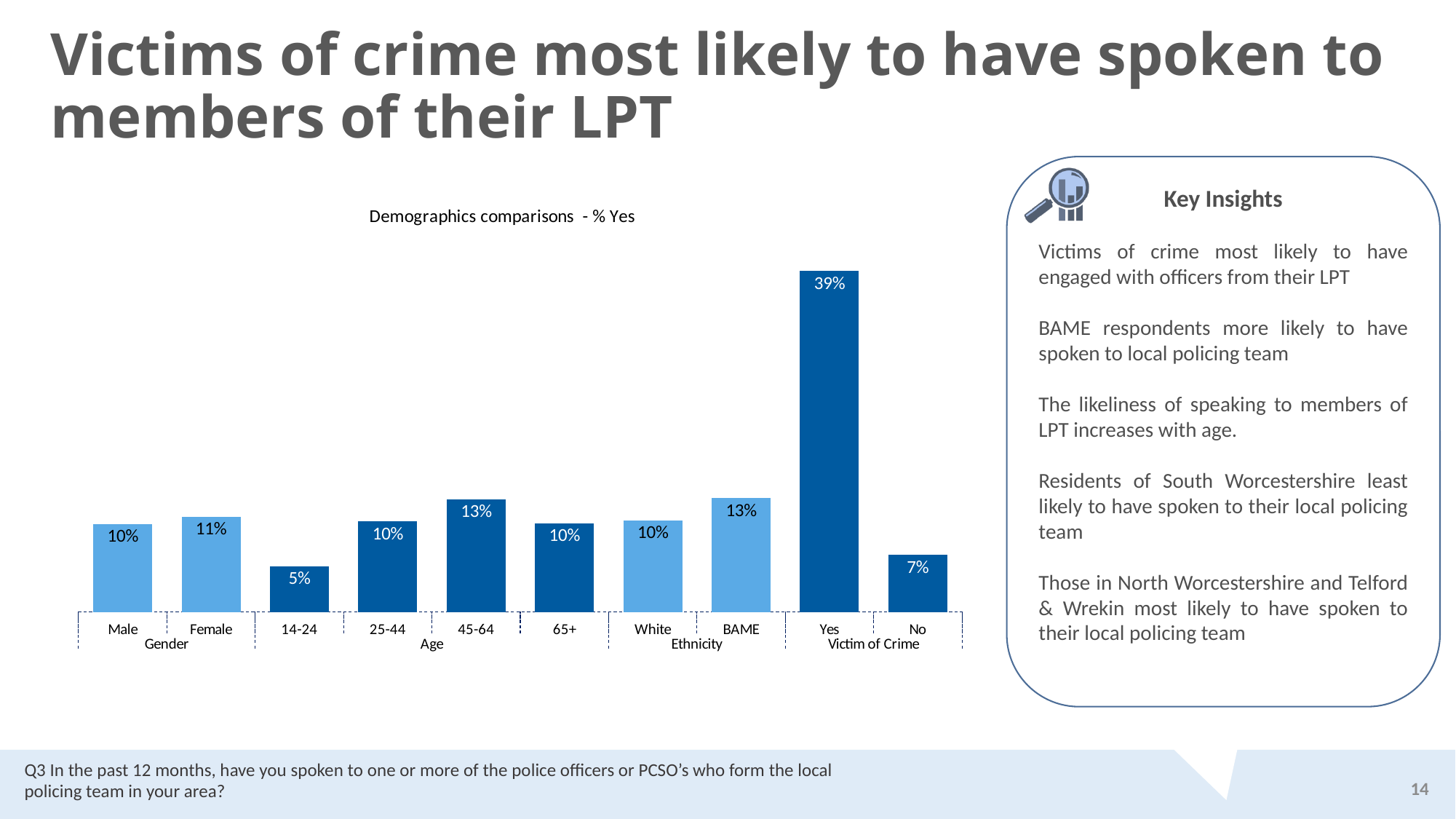
What is the value for victims of crime who answered Yes? 39% Which is larger, the value for White or the value for BAME? BAME What is the title of the chart? Demographics comparisons - % Yes How many bars are plotted in the chart? 10 Which category has the lowest value in the chart? 14-24 What is the value for Male in the Demographics comparisons chart? 10% What is the difference between the Yes and No values under Victim of Crime? 32 percentage points What is the value for the 14-24 age group? 5% What kind of chart is shown on the slide? Bar chart What is the value for BAME respondents? 13% What is the value for Female? 11% Which category has the highest value in the chart? Yes (Victim of Crime)